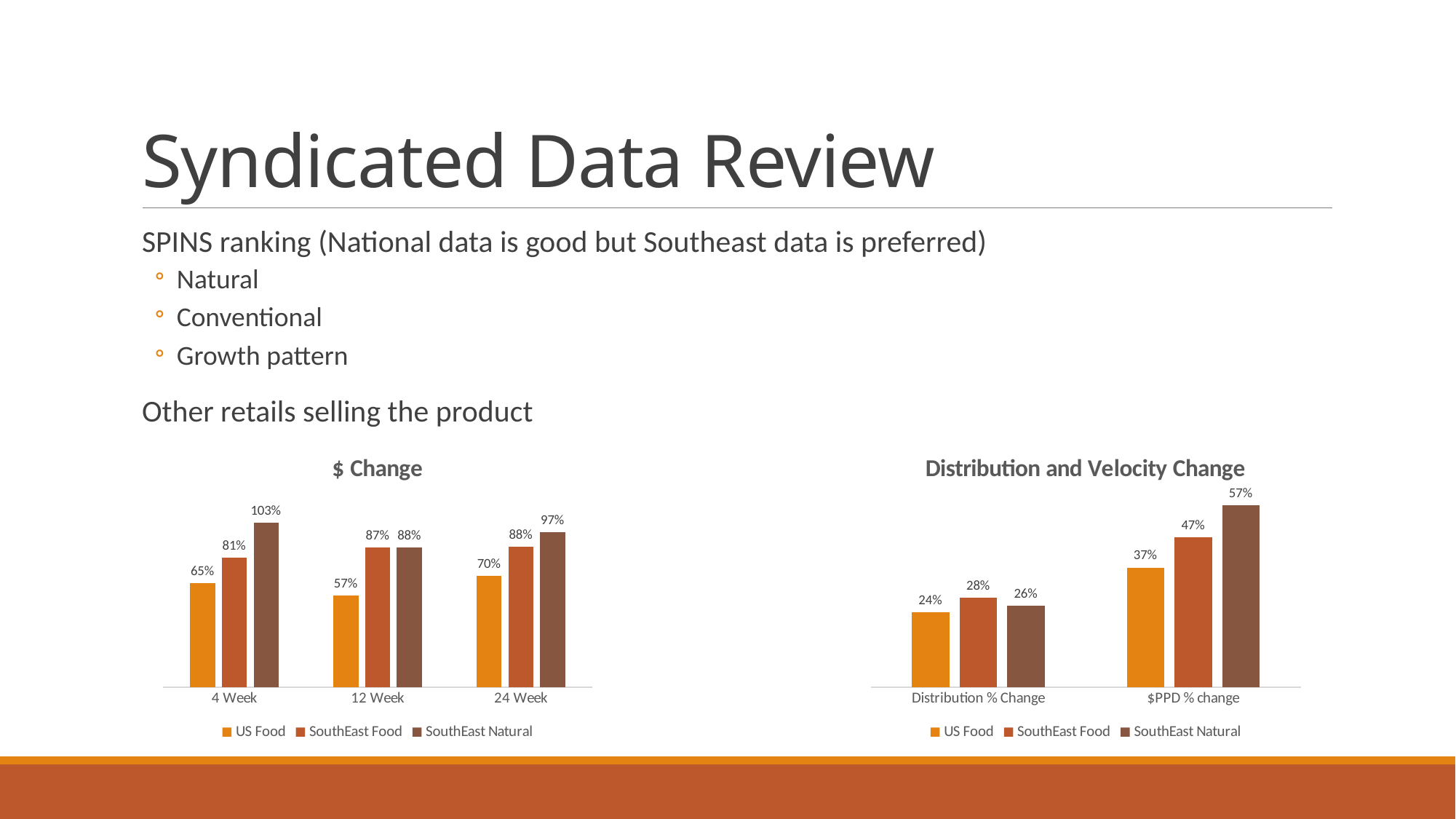
In the "$ Change" chart, which series has the highest value at 24 Week? SouthEast Natural How many series does the legend of the "Distribution and Velocity Change" chart list? 3 What kind of chart is the "$ Change" chart? Bar chart In the "Distribution and Velocity Change" chart, what is the difference between SouthEast Natural and US Food for $PPD % change? 20% In the "$ Change" chart, does the US Food value rise or fall from 12 Week to 24 Week? rise In the "$ Change" chart, what is the value for US Food at 12 Week? 57% In the "$ Change" chart, what is the difference between SouthEast Food and US Food at 4 Week? 16% In the "$ Change" chart, what is the value for SouthEast Natural at 4 Week? 103% In the "Distribution and Velocity Change" chart, is the value for SouthEast Natural for $PPD % change larger than the value for US Food for $PPD % change? Yes In the "Distribution and Velocity Change" chart, which series has the lowest value for Distribution % Change? US Food In the "Distribution and Velocity Change" chart, what is the value for SouthEast Food for $PPD % change? 47% In the "$ Change" chart, how many categories are shown on the x axis? 3